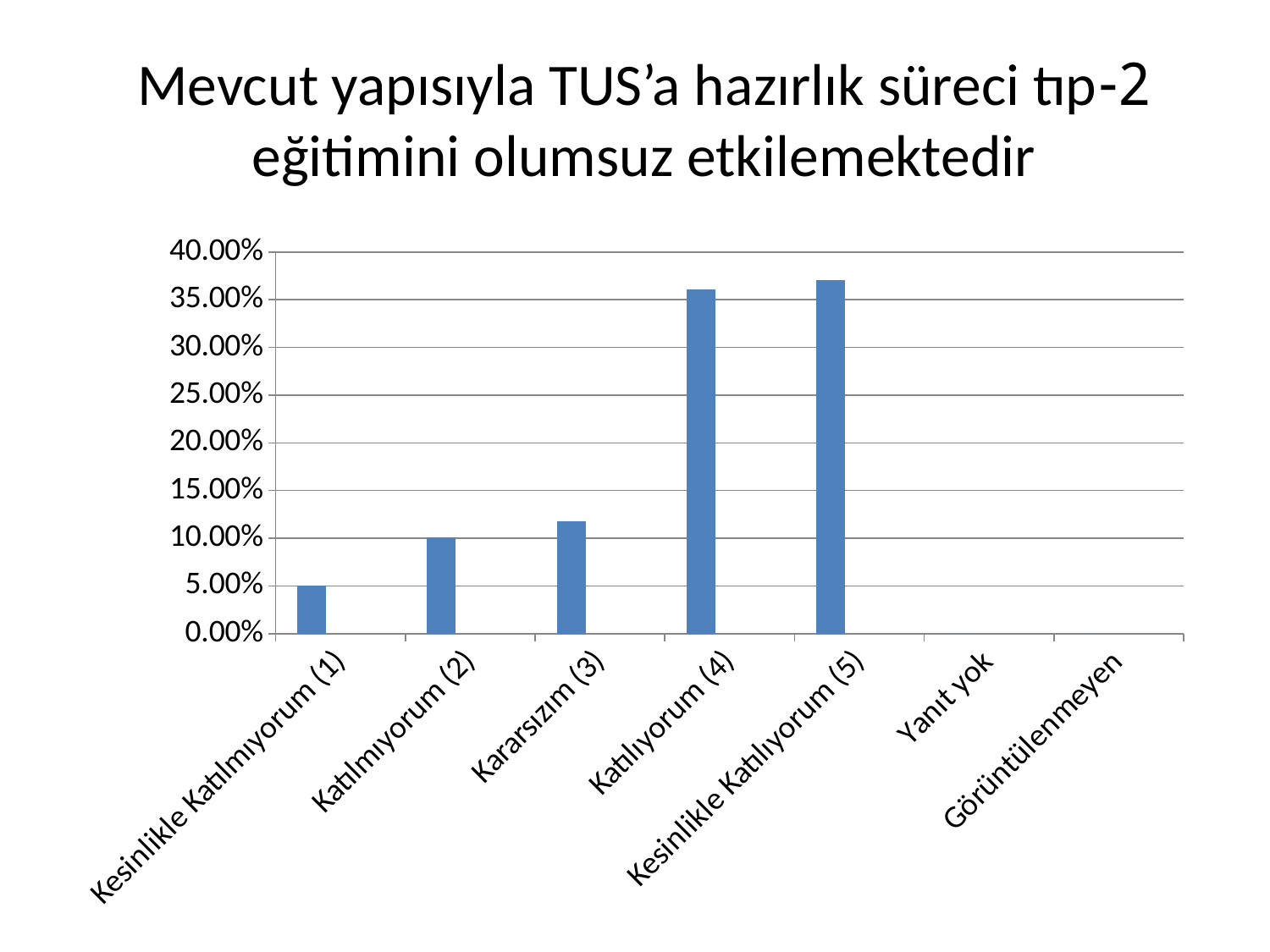
Do the values rise or fall from Kesinlikle Katılmıyorum (1) to Kesinlikle Katılıyorum (5)? rise Is the value for Katılıyorum (4) greater or less than 35%? greater Is the value for Kesinlikle Katılıyorum (5) greater or less than 35%? greater How many categories are shown on the x axis of the chart? 7 What kind of chart is shown on the slide? bar chart Is the value for Kararsızım (3) greater or less than 10%? greater Among the five response categories (1) to (5), which has the lowest value? Kesinlikle Katılmıyorum (1) What is the title of the slide above the chart? Mevcut yapısıyla TUS'a hazırlık süreci tıp-2 eğitimini olumsuz etkilemektedir Which is larger, the value for Katılıyorum (4) or the value for Kararsızım (3)? Katılıyorum (4)